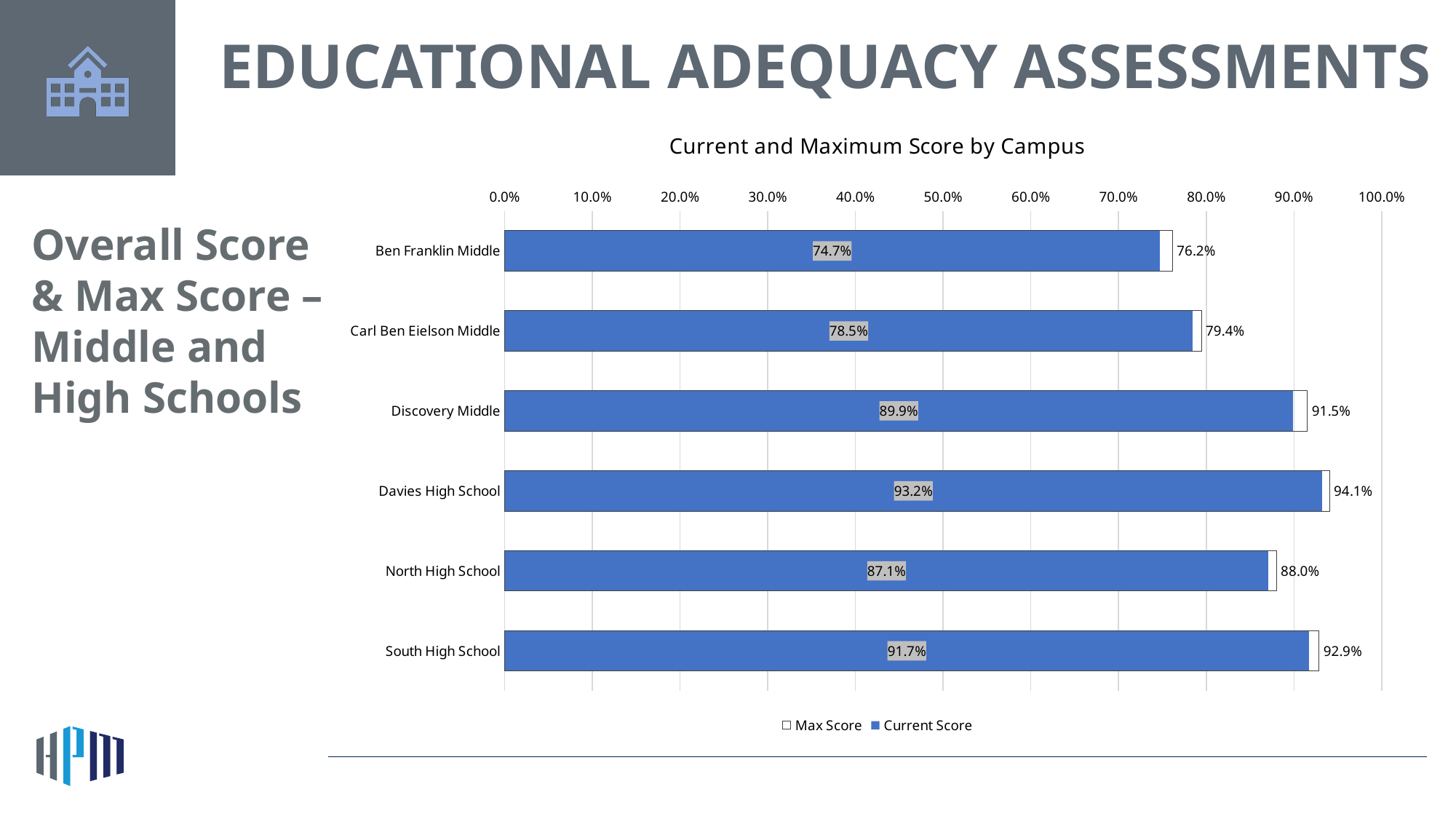
Which campus has the lowest Max Score? Ben Franklin Middle Is the Current Score for Davies High School greater or less than 90.0%? greater How many series does the legend list? 2 What is the Max Score for North High School? 88.0% What is the Current Score for Discovery Middle? 89.9% Which campus has the highest Current Score? Davies High School What is the title of the chart? Current and Maximum Score by Campus What is the difference between the Max Score and the Current Score for South High School? 1.2% How many campuses are shown on the chart? 6 What kind of chart is shown on the slide? Bar chart What is the Current Score for Ben Franklin Middle? 74.7% Which is larger, the Current Score for Carl Ben Eielson Middle or the Current Score for North High School? North High School